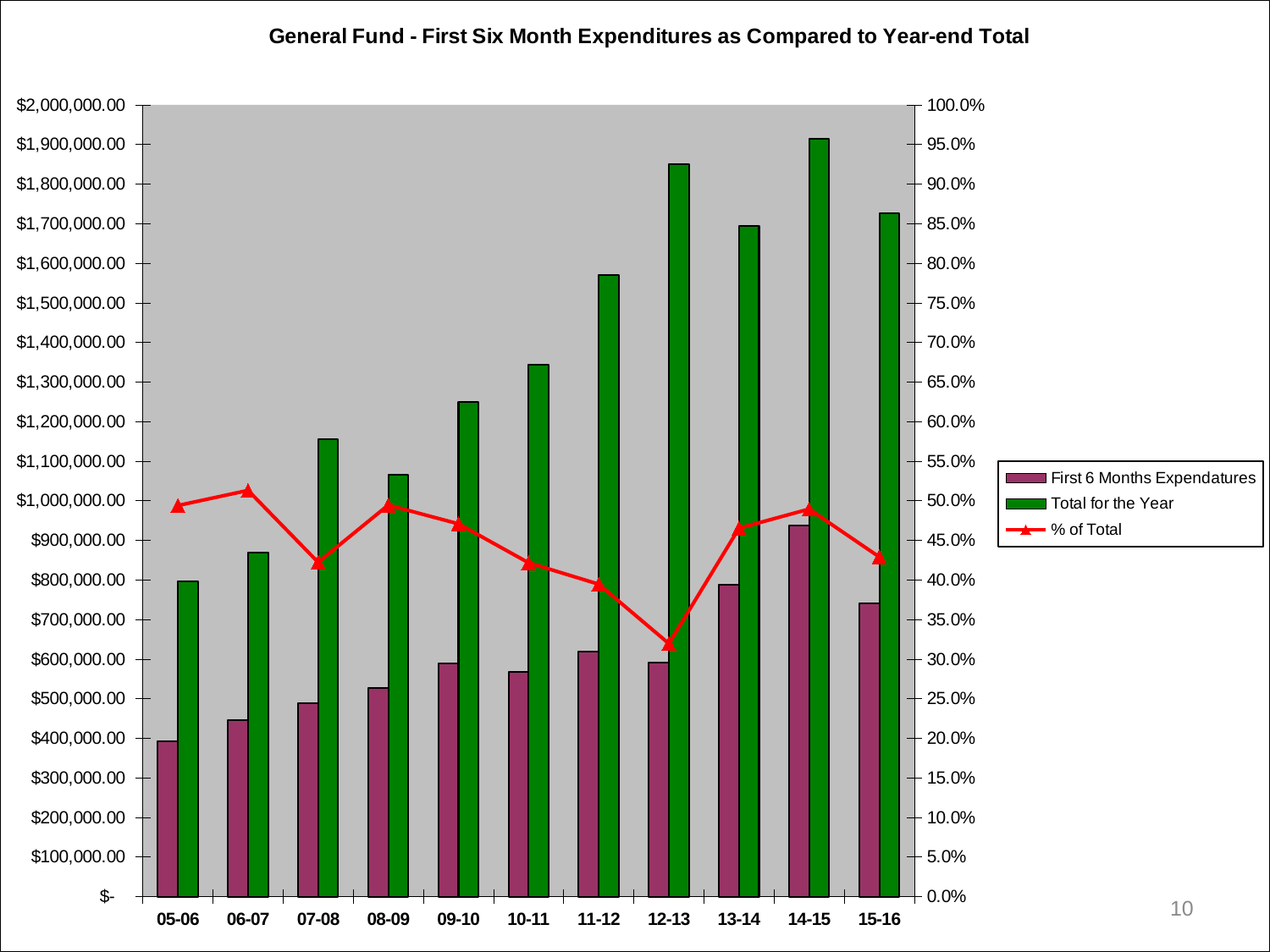
How many fiscal years are shown on the x axis? 11 Which is larger, the Total for the Year in 12-13 or in 13-14? 12-13 Which fiscal year has the highest First 6 Months Expendatures? 14-15 Is the Total for the Year in 12-13 greater or less than $1,800,000.00? greater Is the % of Total for 12-13 greater or less than 35.0%? less Is the First 6 Months Expendatures value for 14-15 greater or less than $900,000.00? greater How many series does the legend list? 3 Which fiscal year has the highest Total for the Year? 14-15 What is the title of the chart? General Fund - First Six Month Expenditures as Compared to Year-end Total Which fiscal year has the lowest % of Total? 12-13 Which is larger, the First 6 Months Expendatures in 13-14 or in 15-16? 13-14 Which fiscal year has the lowest Total for the Year? 05-06